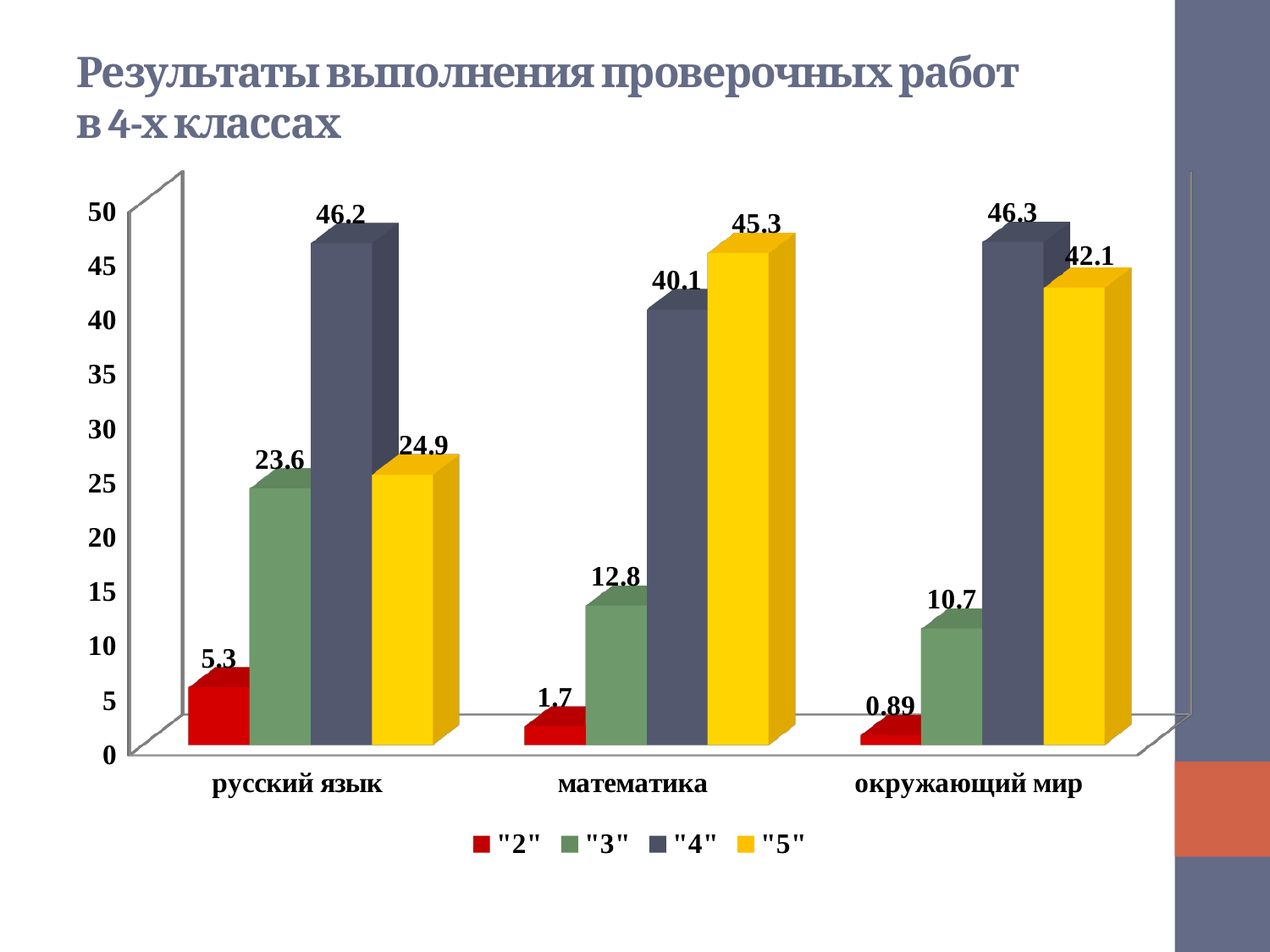
How many series does the legend list? 4 What is the value for "4" in русский язык? 46.2 How many categories are shown on the x axis? 3 What colour are the bars for series "5"? Yellow What is the difference between the "4" and "5" values in окружающий мир? 4.2 What kind of chart is shown on the slide? Bar chart Which is larger in математика: the value for "4" or the value for "5"? "5" Which series has the highest value in русский язык? "4" What is the value for "2" in окружающий мир? 0.89 What is the value for "3" in математика? 12.8 Which series has the lowest value in математика? "2" What is the value for "5" in математика? 45.3